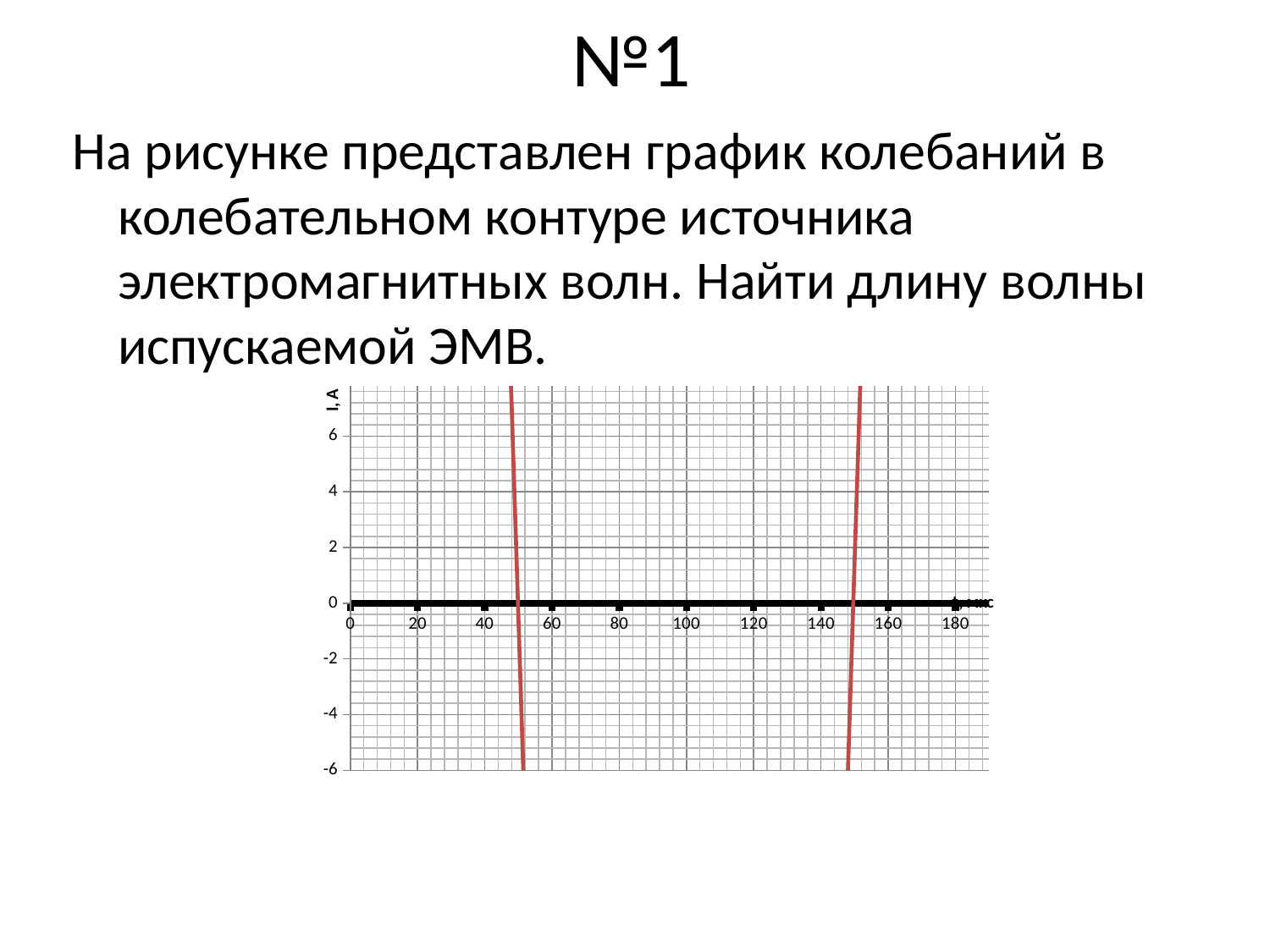
What is the label of the vertical axis of the chart? I, A What is the spacing between consecutive labelled ticks on the horizontal axis of the chart? 20 What is the lowest value labelled on the vertical axis of the chart? -6 What is the largest value labelled on the horizontal axis of the chart? 180 How many red line segments are visible on the chart? 2 Is the horizontal-axis value where the first red line crosses zero greater or less than 40? greater What is the highest value labelled on the vertical axis of the chart? 6 What kind of chart is shown on the slide? line chart Is the horizontal-axis value where the second red line crosses zero greater or less than 140? greater Is the horizontal-axis value where the first red line crosses zero greater or less than 60? less What colour is the plotted line on the chart? red